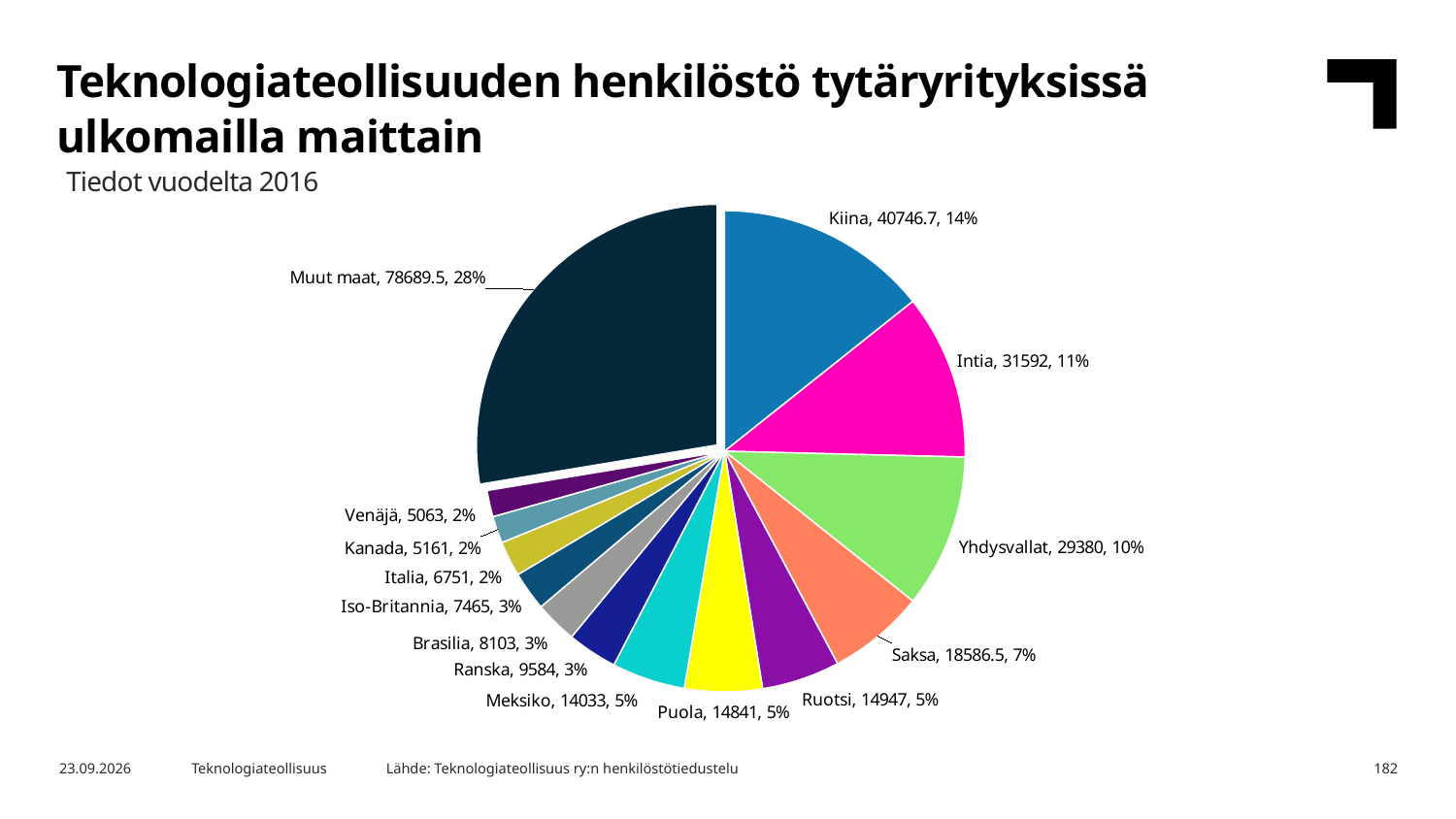
Which slice has the largest value in the pie chart? Muut maat How many slices does the pie chart have? 14 Which slice has the smallest value in the pie chart? Venäjä Which is larger, the value for Ruotsi or the value for Meksiko? Ruotsi What percentage share does Muut maat have in the pie chart? 28% What is the difference between the values for Intia and Yhdysvallat? 2212 What kind of chart is shown on the slide? Pie chart What is the value shown for Kiina? 40746.7 What is the value shown for Iso-Britannia? 7465 What percentage share does Yhdysvallat have in the pie chart? 10% What year does the data on the slide come from, according to the subtitle? 2016 What is the value shown for Saksa? 18586.5